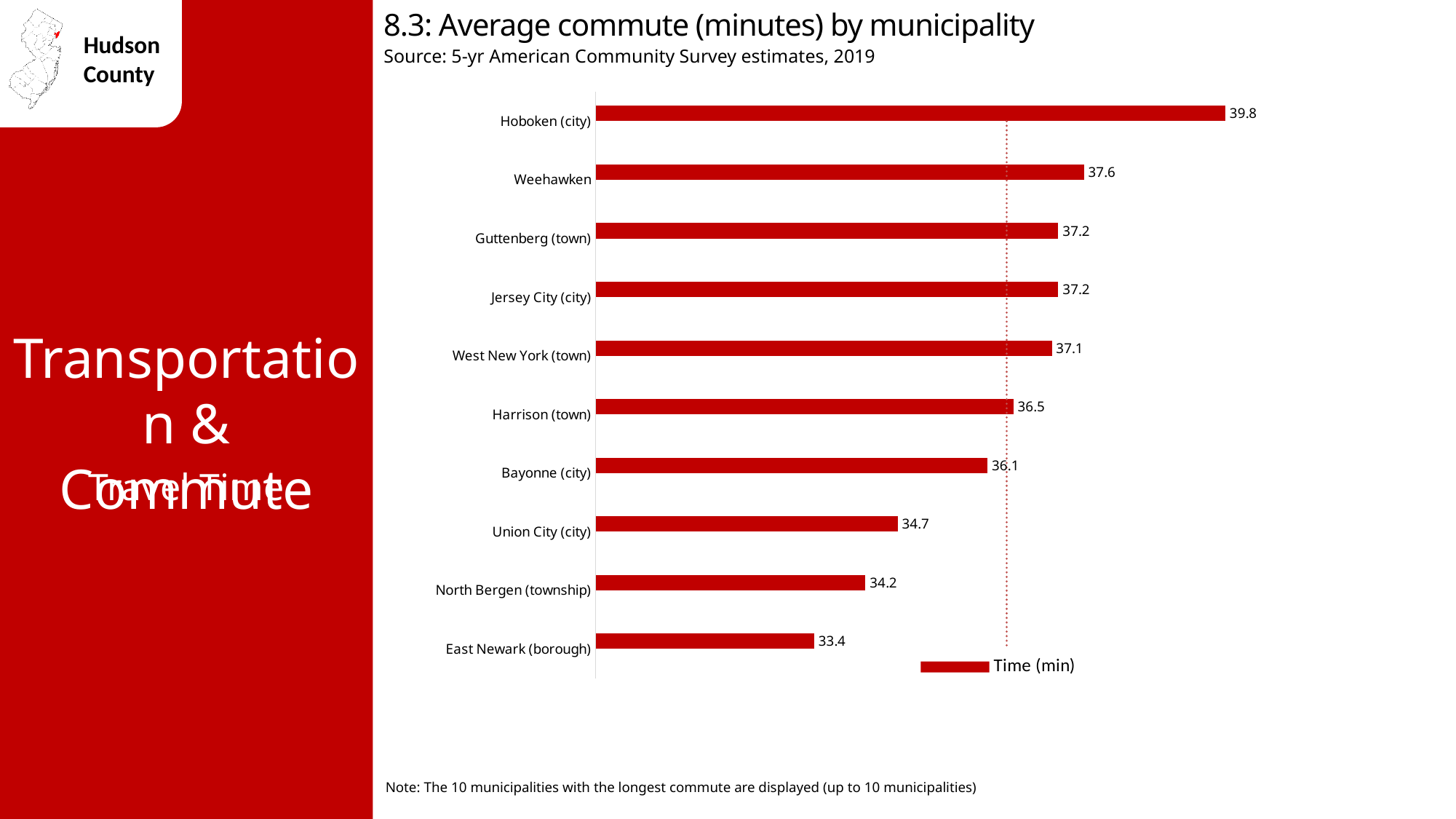
What is the average commute time for Hoboken (city)? 39.8 What is the difference in average commute time between Weehawken and Union City (city)? 2.9 What is the average commute time for Bayonne (city)? 36.1 What is the difference in average commute time between Hoboken (city) and East Newark (borough)? 6.4 Which municipality has the shortest average commute shown on the chart? East Newark (borough) What kind of chart is shown on the slide? Bar chart Which has a longer average commute, Harrison (town) or North Bergen (township)? Harrison (town) How many series does the legend list? 1 Which municipality has the longest average commute? Hoboken (city) How many municipalities are shown on the chart? 10 What is the average commute time for East Newark (borough)? 33.4 What is the legend entry for the series on the chart? Time (min)